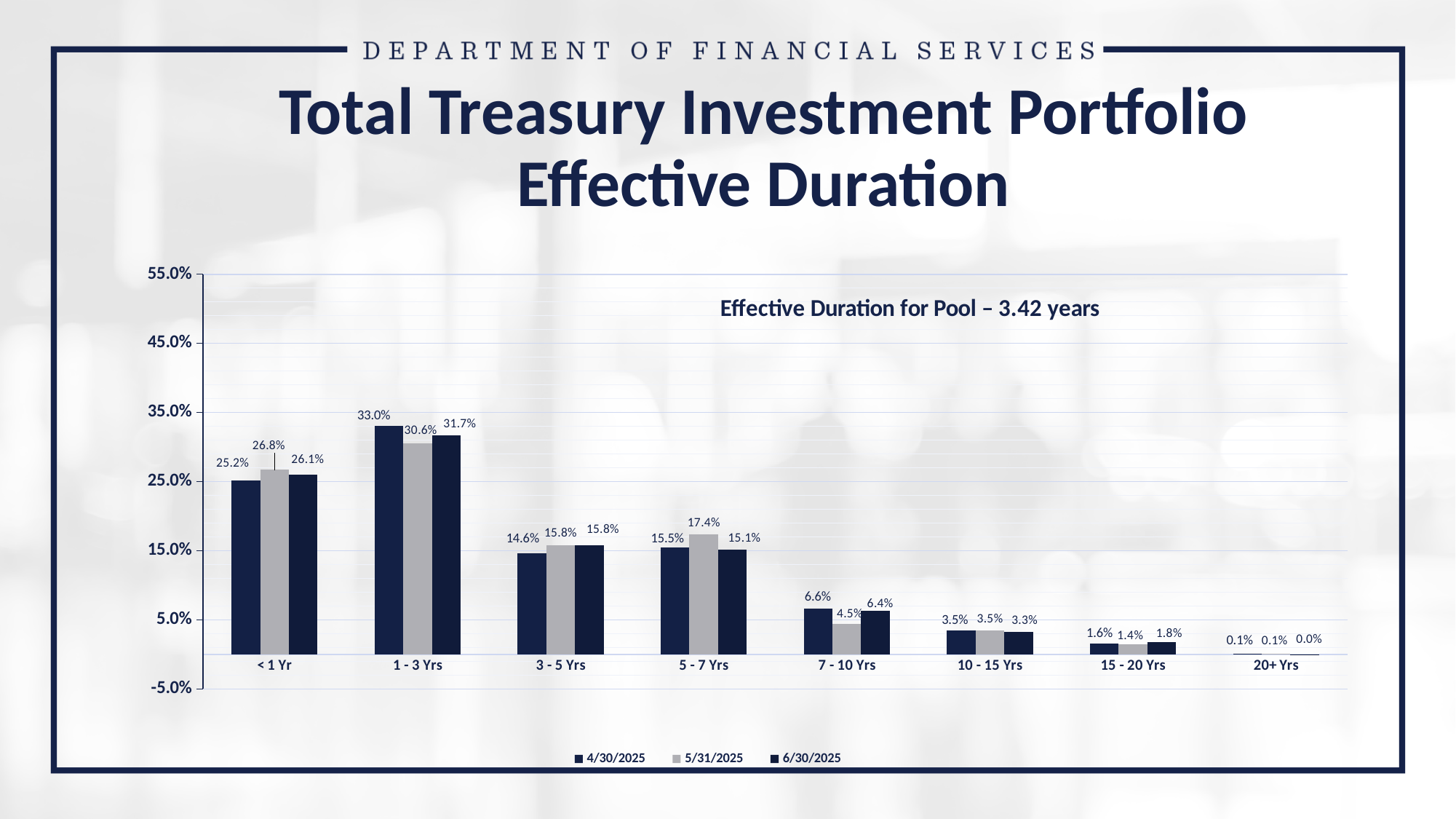
How many categories are shown on the x axis? 8 What is the difference between the 4/30/2025 and 5/31/2025 values for the 7 - 10 Yrs category? 2.1% Which is larger for the < 1 Yr category: the 5/31/2025 value or the 6/30/2025 value? 5/31/2025 Do the 4/30/2025 values generally rise or fall from the 1 - 3 Yrs category to the 20+ Yrs category? Fall What is the value for the 5 - 7 Yrs category in the 5/31/2025 series? 17.4% What is the value for the 7 - 10 Yrs category in the 6/30/2025 series? 6.4% What is the value for the 1 - 3 Yrs category in the 4/30/2025 series? 33.0% What effective duration for the pool is stated on the chart? 3.42 years How many series does the legend list? 3 Which category has the highest value in the 6/30/2025 series? 1 - 3 Yrs Which category has the lowest value in the 4/30/2025 series? 20+ Yrs What kind of chart is shown on the slide? Bar chart